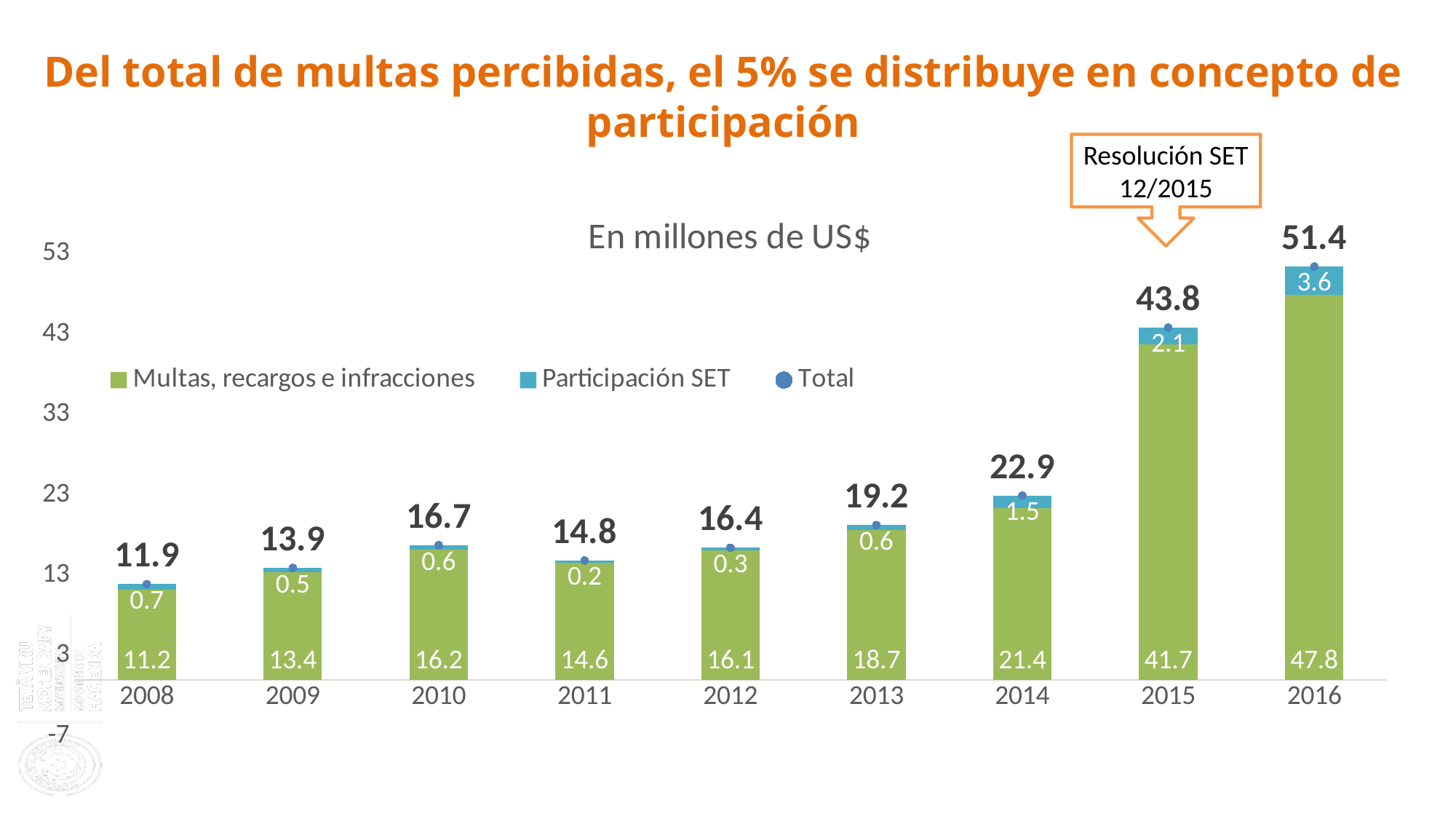
What kind of chart is shown on the slide? stacked bar chart What is the value of 'Participación SET' for 2015? 2.1 How many series does the legend list? 3 What unit is stated in the chart subtitle? En millones de US$ What is the difference between the Total for 2016 and the Total for 2015? 7.6 Which year has the lowest Total? 2008 How many years are shown on the x axis? 9 What is the Total for 2013? 19.2 Is the Total for 2015 greater or less than 33? greater Which is larger, the 'Participación SET' value for 2014 or for 2013? 2014 What is the value of 'Multas, recargos e infracciones' for 2016? 47.8 Which year has the highest Total? 2016